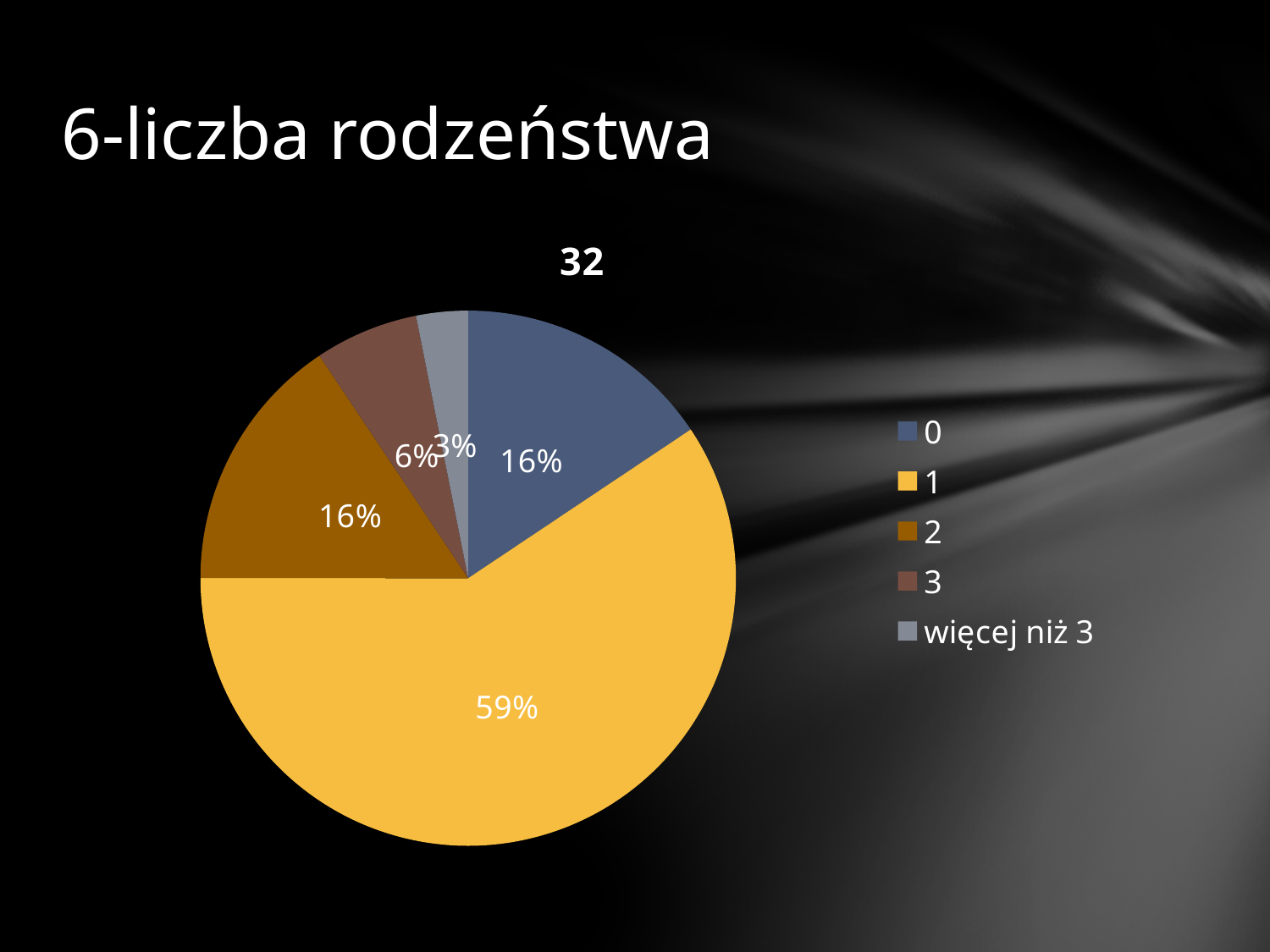
What share of the pie does the category "więcej niż 3" take? 3% What is the last entry listed in the legend? więcej niż 3 Which category has the smallest slice of the pie? więcej niż 3 What share of the pie does the category "1" take? 59% What is the difference in percentage points between the slices for "1" and "2"? 43 How many slices does the pie chart have? 5 Which slice is larger, "3" or "więcej niż 3"? 3 What kind of chart is shown on the slide? pie chart Which category has the largest slice of the pie? 1 What share of the pie does the category "0" take? 16% What is the title of the chart? 32